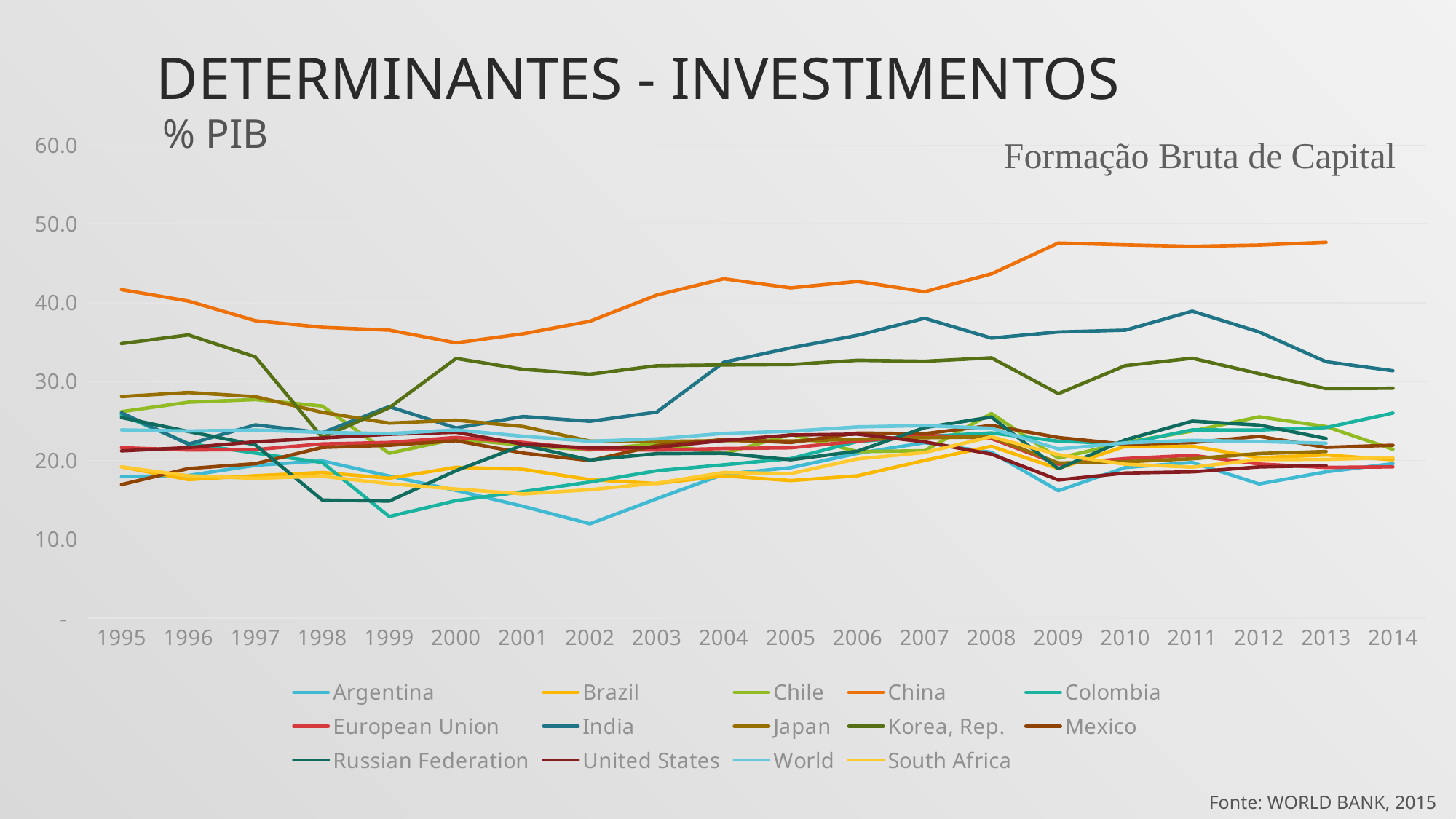
Is the value for China in 2009 greater or less than 40.0? greater How many years are shown along the x axis? 20 How many series does the legend list? 14 What kind of chart is shown on the slide? line chart Which series has the highest value in 1995? China Which series has the highest value in 2014? India Is the value for Brazil in 2014 greater or less than 30.0? less Is the value for India in 2011 greater or less than 30.0? greater Does the value for China rise or fall overall from 1995 to 2014? rise What is the title of the chart? Formação Bruta de Capital What source is cited for the chart data? WORLD BANK, 2015